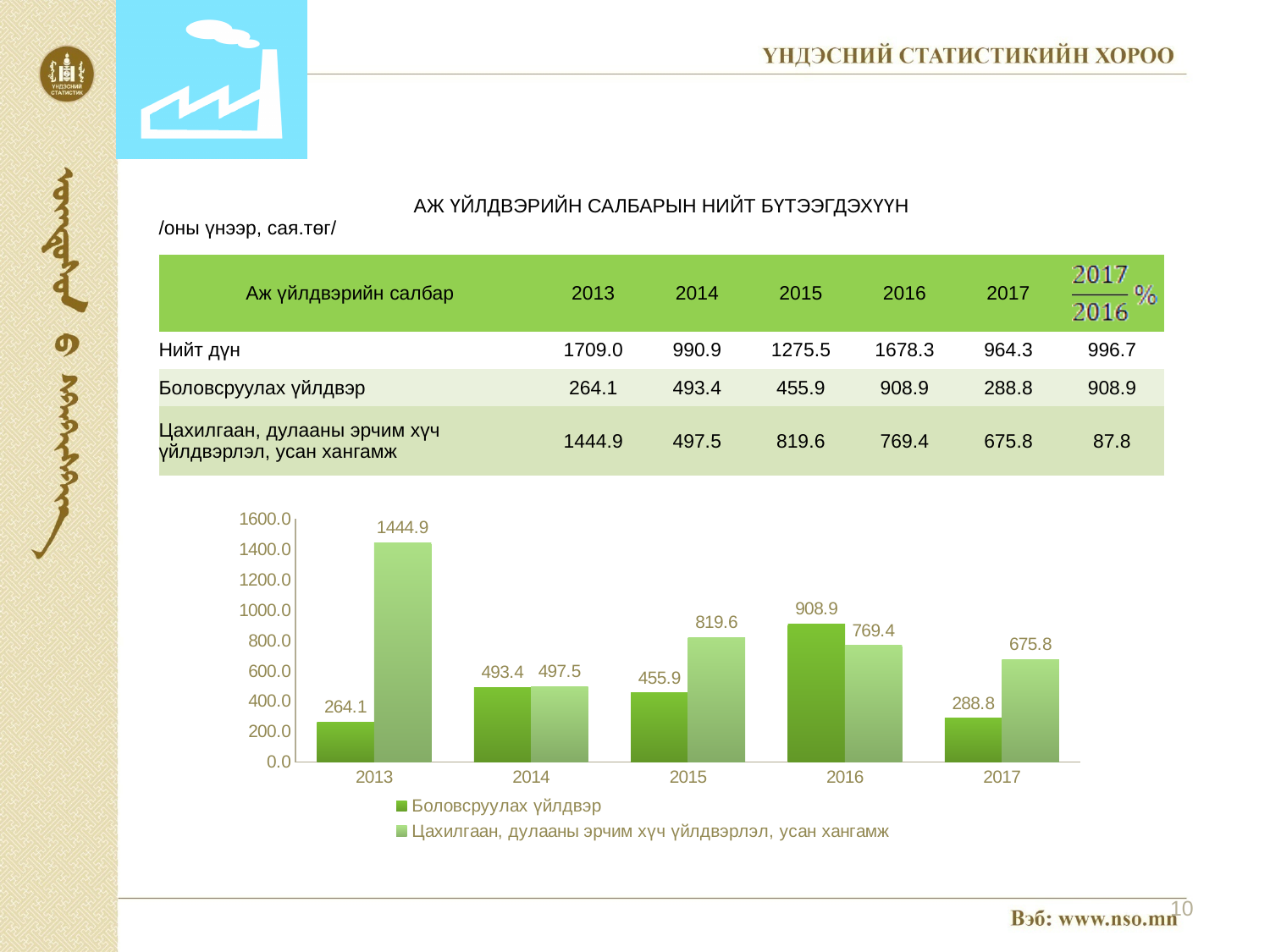
How many years are shown on the x axis of the chart? 5 In which year is the value for Боловсруулах үйлдвэр lowest? 2013 What is the value for Боловсруулах үйлдвэр in 2017? 288.8 What is the value for Цахилгаан, дулааны эрчим хүч үйлдвэрлэл, усан хангамж in 2013? 1444.9 What type of chart is shown on the slide? bar chart What is the value for Боловсруулах үйлдвэр in 2016? 908.9 Is the value for Цахилгаан, дулааны эрчим хүч үйлдвэрлэл, усан хангамж in 2015 greater or less than 800.0? greater What is the difference between the two series' values in 2013? 1180.8 In which year is the value for Цахилгаан, дулааны эрчим хүч үйлдвэрлэл, усан хангамж highest? 2013 How many series does the chart legend list? 2 Which series has the larger value in 2016? Боловсруулах үйлдвэр Which series is shown in the darker green colour in the chart? Боловсруулах үйлдвэр